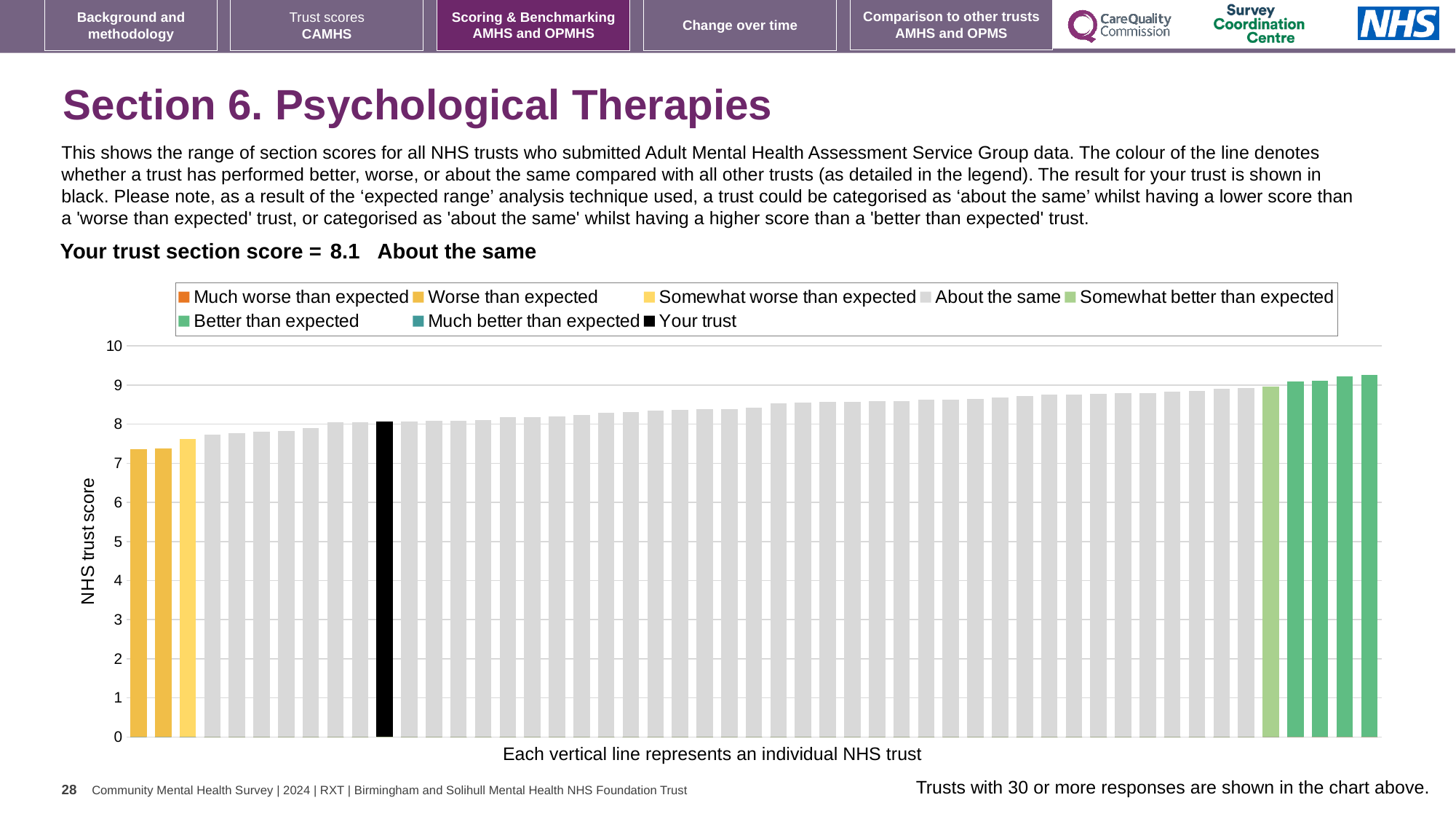
How many bars are coloured as 'Worse than expected'? 2 What is the label on the vertical axis of the chart? NHS trust score How many entries does the chart legend list? 8 Is the value of the leftmost bar greater or less than 8? less Do the bar values rise or fall from left to right along the x axis? rise Which is larger, the leftmost bar or the rightmost bar? the rightmost bar Is the value of the black 'Your trust' bar greater or less than 5? greater How many bars are coloured as 'Better than expected'? 4 Is the value of the rightmost bar greater or less than 9? greater Which legend category does your trust's score fall into? About the same What is the section score for your trust shown on the slide? 8.1 What kind of chart is shown on the slide? bar chart